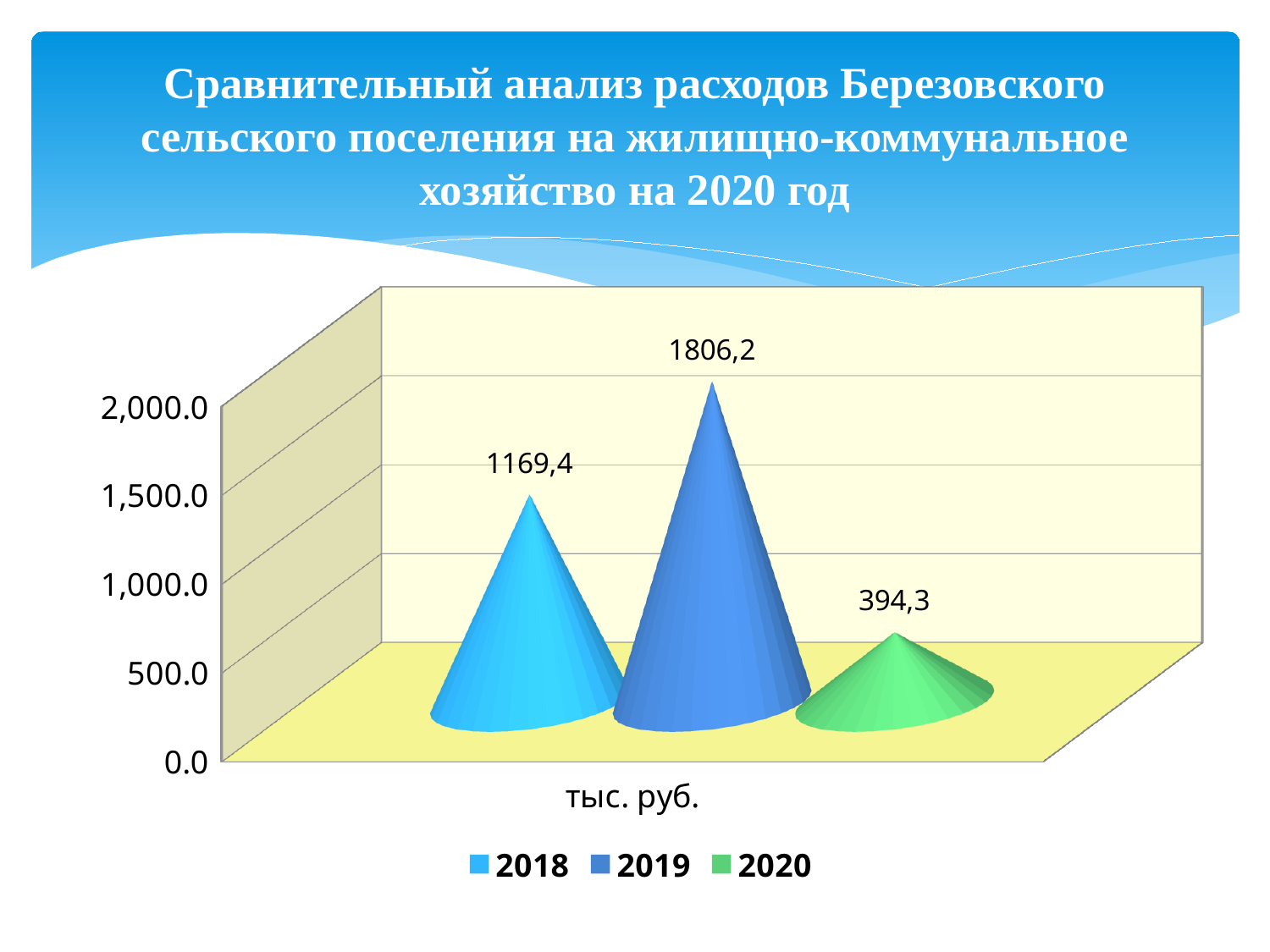
How many series does the legend list? 3 What is the difference between the values for 2019 and 2018? 636,8 What is the value for 2018? 1169,4 Which is larger, the value for 2018 or the value for 2020? 2018 Which year has the highest value? 2019 What is the value for 2020? 394,3 Which year has the lowest value? 2020 What kind of chart is shown on the slide? bar chart What is the difference between the values for 2018 and 2020? 775,1 What unit label is shown under the chart's category axis? тыс. руб. What is the value for 2019? 1806,2 Is the value for 2020 greater or less than 500.0? less